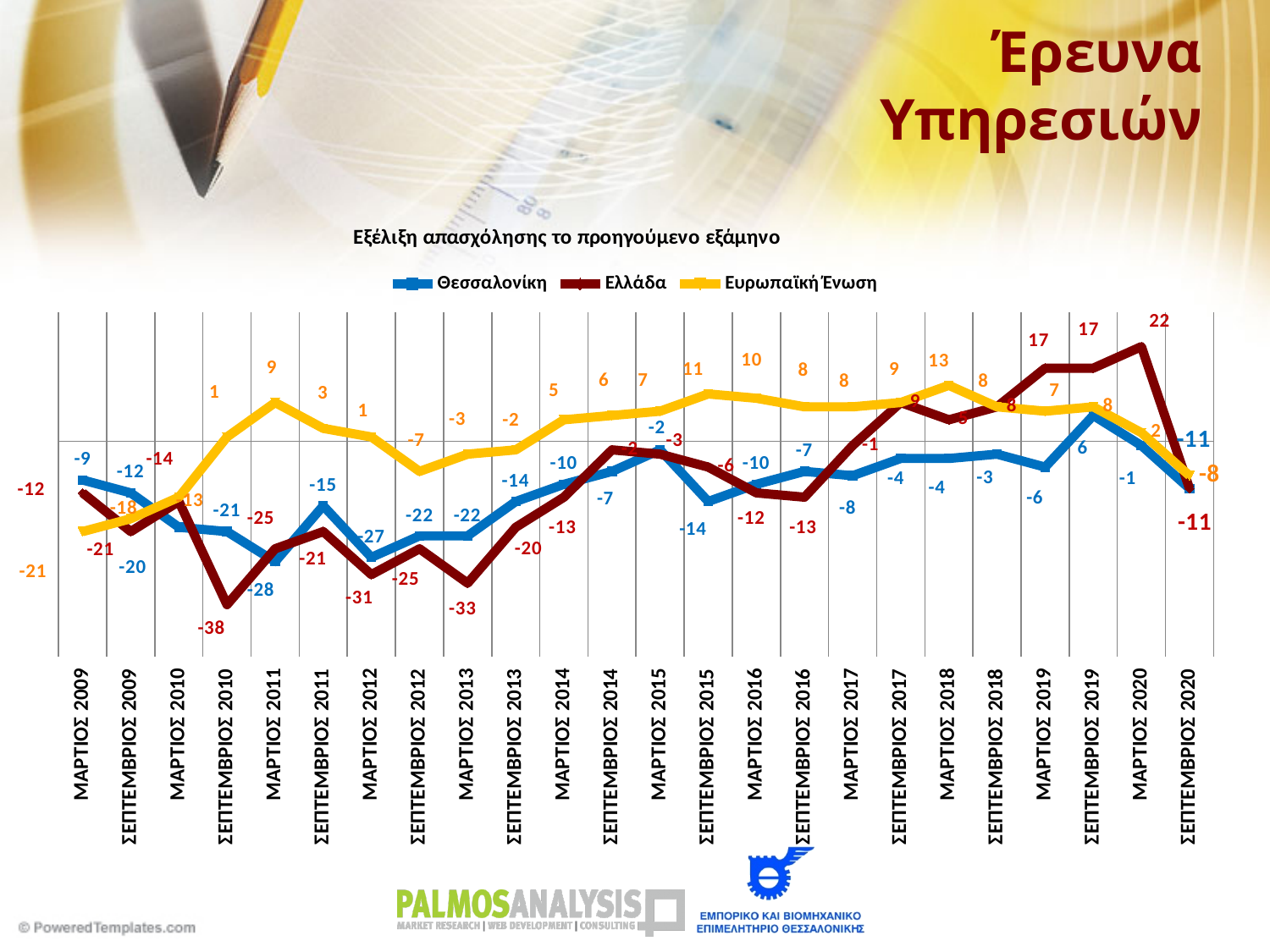
In which period does the Ελλάδα series reach its lowest value? ΣΕΠΤΕΜΒΡΙΟΣ 2010 In ΣΕΠΤΕΜΒΡΙΟΣ 2019, which is larger: the value for Θεσσαλονίκη or for Ευρωπαϊκή Ένωση? Ευρωπαϊκή Ένωση What type of chart is shown on the slide? Line chart What is the value for Ελλάδα in ΜΑΡΤΙΟΣ 2013? -33 What is the difference between the Ελλάδα and Θεσσαλονίκη values in ΜΑΡΤΙΟΣ 2020? 23 What is the title of the chart? Εξέλιξη απασχόλησης το προηγούμενο εξάμηνο What is the value for Ευρωπαϊκή Ένωση in ΜΑΡΤΙΟΣ 2018? 13 What is the value for Ελλάδα in ΣΕΠΤΕΜΒΡΙΟΣ 2010? -38 How many series does the legend list? 3 In which period does the Ελλάδα series reach its highest value? ΜΑΡΤΙΟΣ 2020 How many time points are shown on the x axis? 24 What is the value for Θεσσαλονίκη in ΣΕΠΤΕΜΒΡΙΟΣ 2019? 6